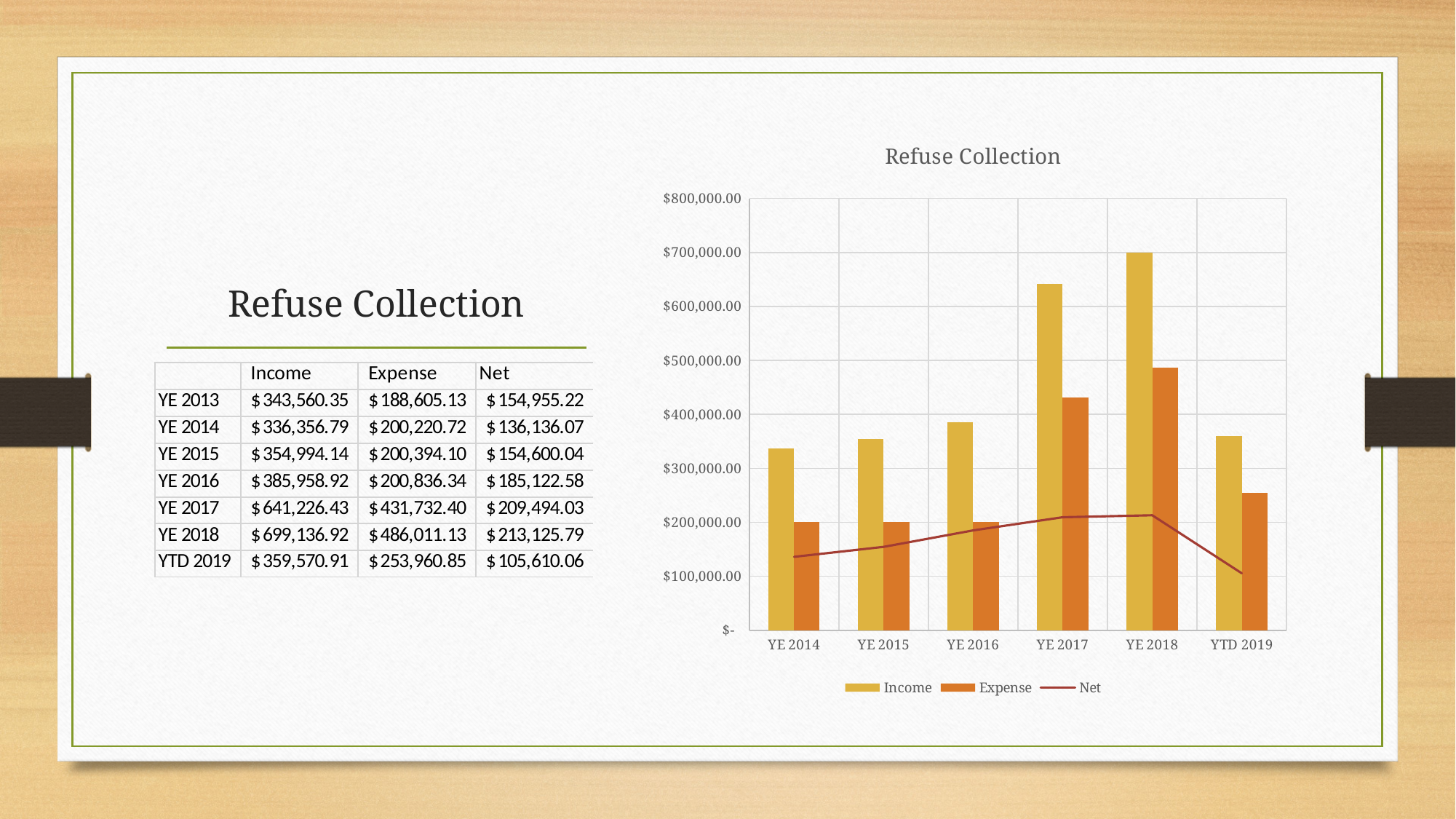
Which category has the highest Income bar in the chart? YE 2018 What is the title of the chart? Refuse Collection Which category has the lowest Net value in the chart? YTD 2019 Is the Income value for YE 2017 greater or less than $600,000.00? greater Which is larger in the chart, the Expense for YE 2018 or the Expense for YE 2017? Expense for YE 2018 Is the Expense value for YE 2015 greater or less than $300,000.00? less According to the table on the slide, what is the Income for YE 2018? $ 699,136.92 What type of chart is shown on the slide? bar chart with a line How many series does the chart legend list? 3 According to the table on the slide, what is the Net for YTD 2019? $ 105,610.06 How many categories are shown on the x axis of the chart? 6 Does the Income series rise or fall from YE 2014 to YE 2018 in the chart? rise